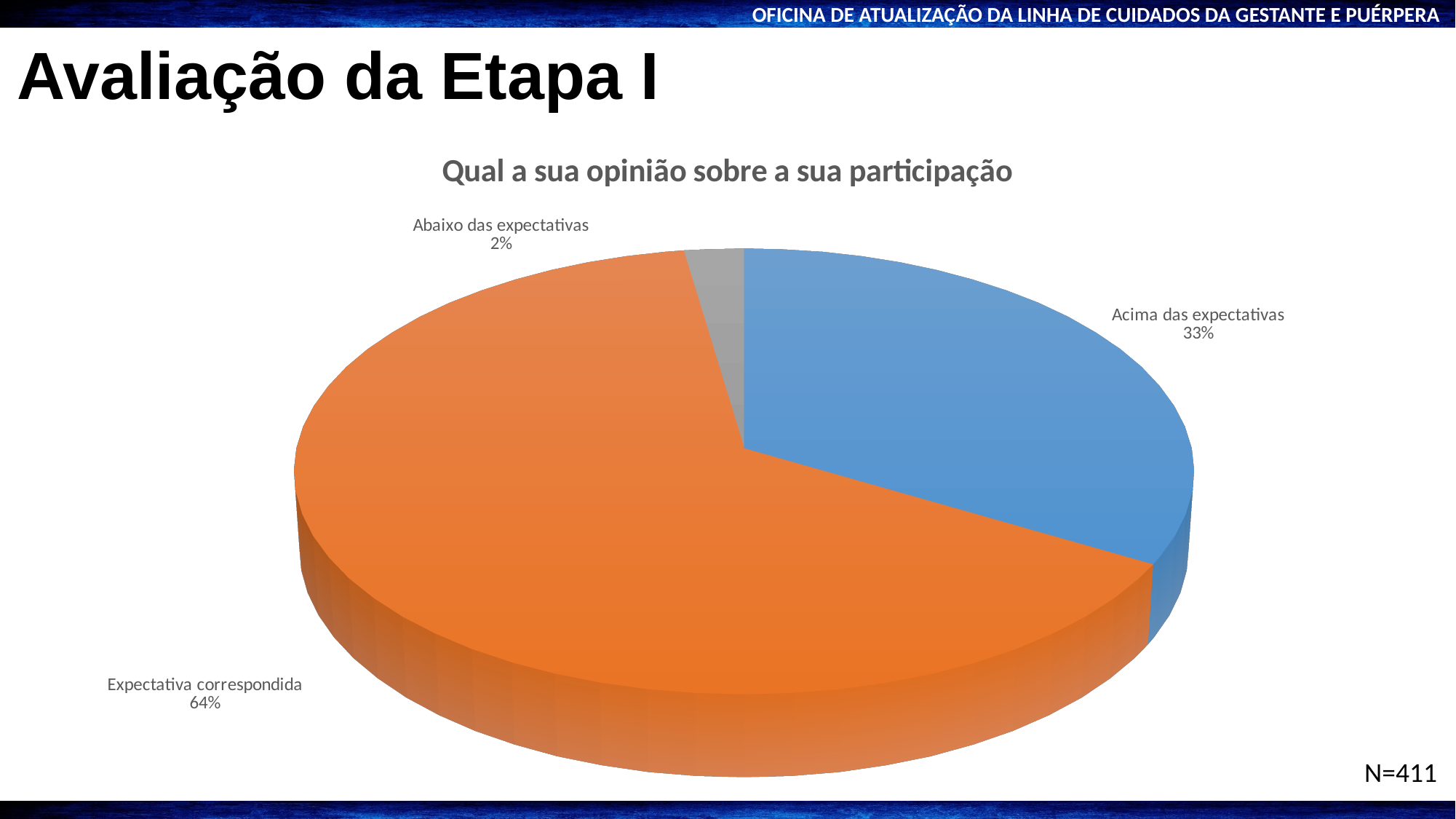
Which category has the largest slice of the pie? Expectativa correspondida What share of the pie does "Acima das expectativas" represent? 33% Which is larger: the share for "Acima das expectativas" or the share for "Abaixo das expectativas"? Acima das expectativas How many categories are shown in the pie chart? 3 What is the difference in percentage points between "Acima das expectativas" and "Abaixo das expectativas"? 31 What share of the pie does "Abaixo das expectativas" represent? 2% What share of the pie does "Expectativa correspondida" represent? 64% What is the difference in percentage points between "Expectativa correspondida" and "Acima das expectativas"? 31 Which category has the smallest slice of the pie? Abaixo das expectativas What is the title of the chart? Qual a sua opinião sobre a sua participação What kind of chart is shown on the slide? Pie chart What colour is the slice for "Acima das expectativas"? Blue